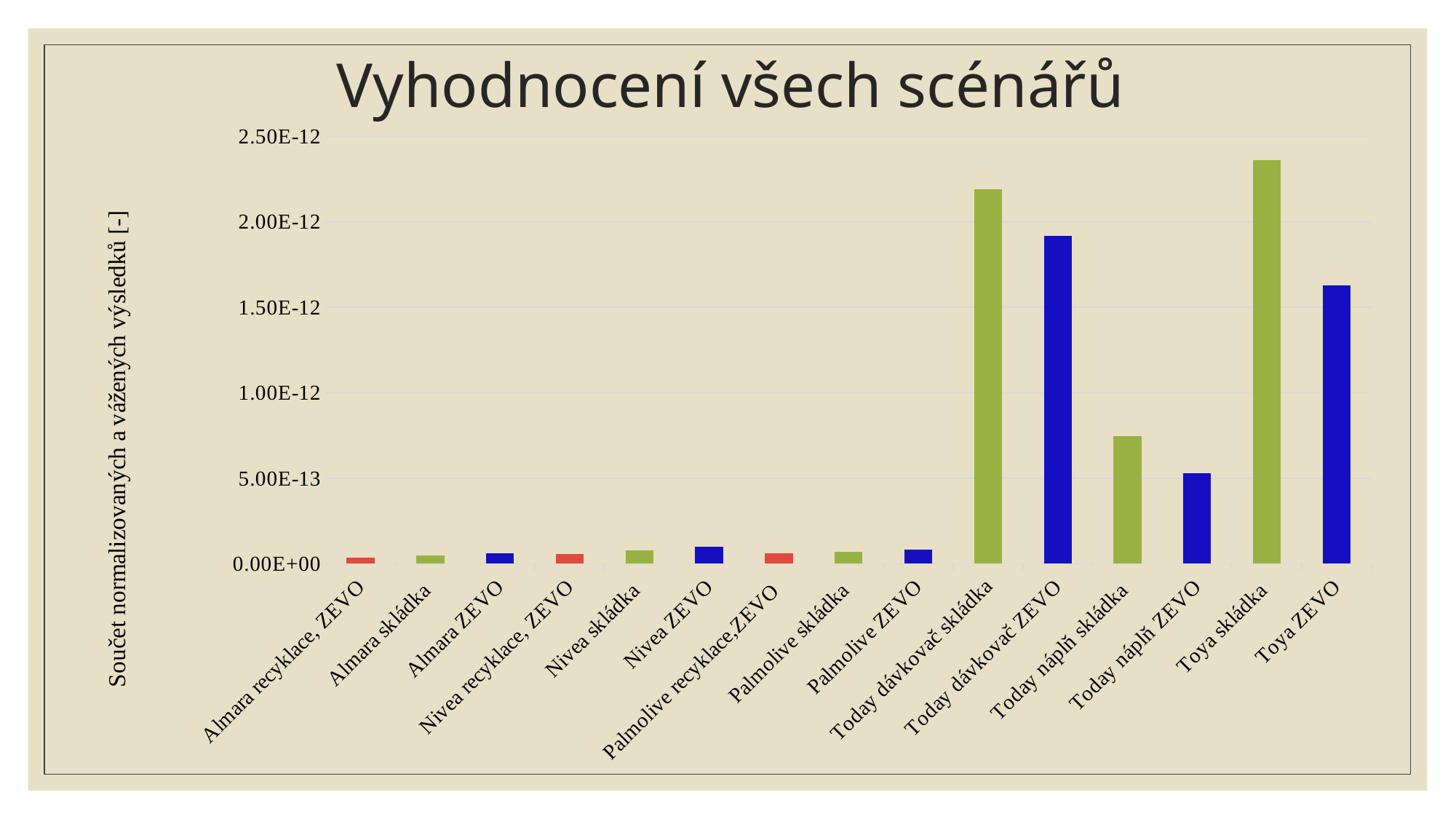
Is the value for Nivea ZEVO greater or less than 5.00E-13? less What is the label of the vertical axis? Součet normalizovaných a vážených výsledků [-] What type of chart is shown on the slide? bar chart Is the value for Toya ZEVO greater or less than 1.50E-12? greater How many categories (bars) are shown on the x axis? 15 Which is larger, the value for Today náplň skládka or Today náplň ZEVO? Today náplň skládka Is the value for Toya skládka greater or less than 2.00E-12? greater What is the title of the chart? Vyhodnocení všech scénářů Which is larger, the value for Today dávkovač skládka or Today dávkovač ZEVO? Today dávkovač skládka Which category has the highest value? Toya skládka